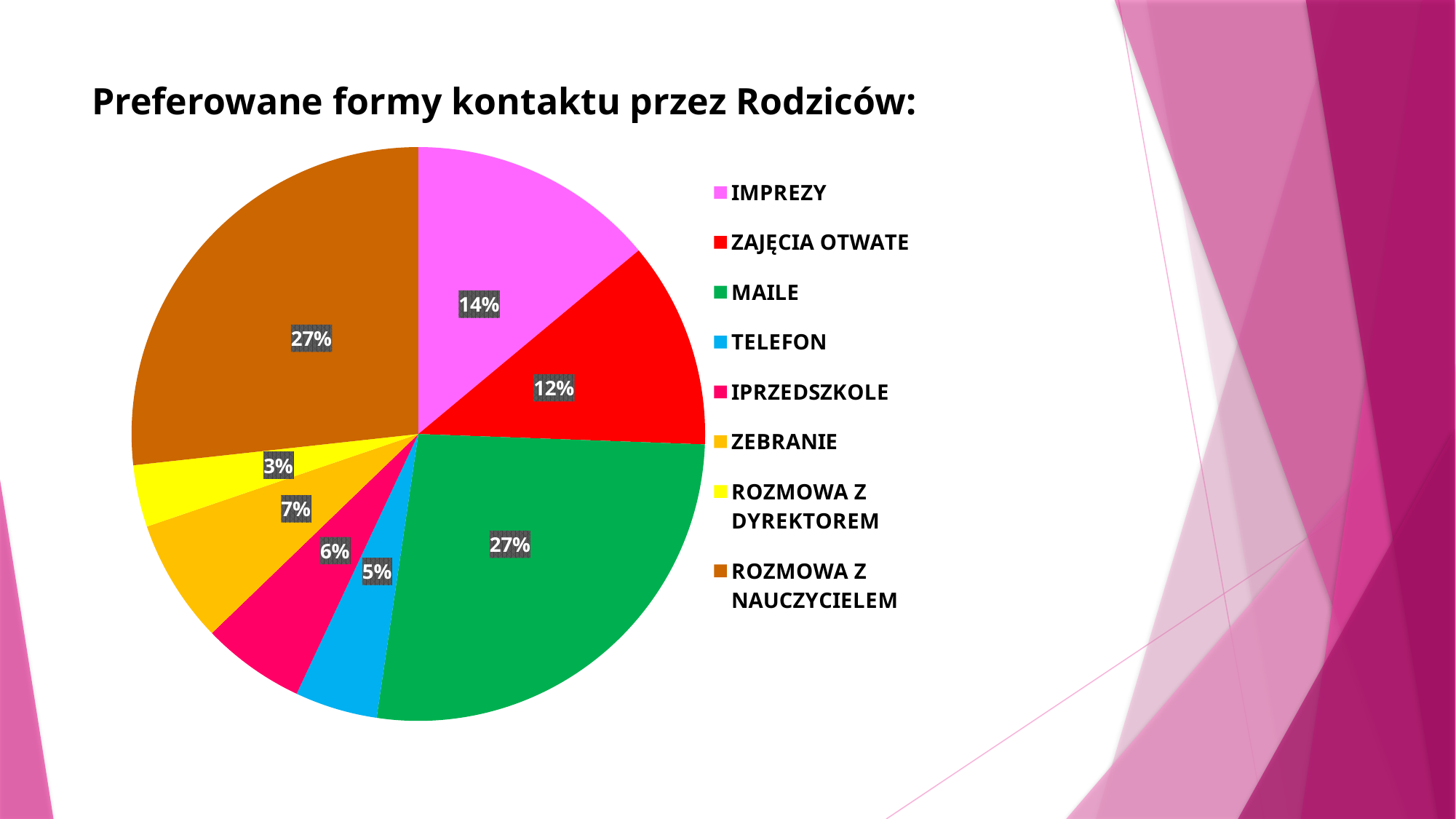
What share of the pie does TELEFON represent? 5% Which category has the smallest slice of the pie? ROZMOWA Z DYREKTOREM What share of the pie does ROZMOWA Z NAUCZYCIELEM represent? 27% What is the title of the chart? Preferowane formy kontaktu przez Rodziców: What kind of chart is shown on the slide? pie chart What share of the pie does IMPREZY represent? 14% Which is larger, the slice for ZEBRANIE or the slice for IPRZEDSZKOLE? ZEBRANIE How many categories does the pie chart show? 8 What is the difference in percentage points between IMPREZY and ZAJĘCIA OTWATE? 2